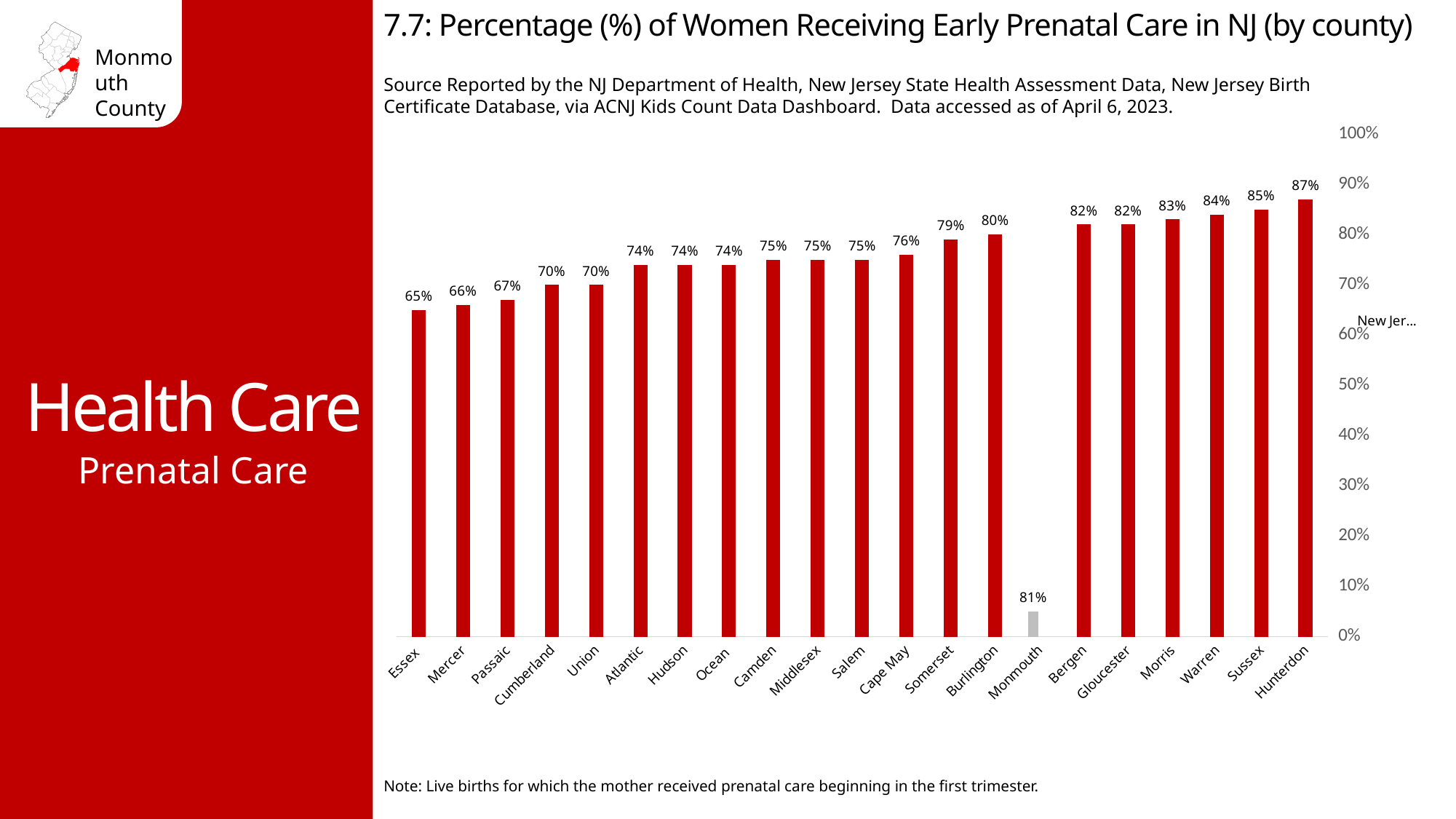
What is the value for Essex County? 65% What is the value for Hunterdon County? 87% Which county's bar is coloured gray instead of red? Monmouth Is the value for Essex greater or less than 70%? less Which is larger, the value for Bergen or the value for Somerset? Bergen What is the difference between the values for Hunterdon and Essex? 22 percentage points How many counties are shown on the x axis? 21 Which county has the lowest percentage of women receiving early prenatal care? Essex Do the values generally rise or fall from left to right along the x axis? rise What is the value for Monmouth County? 81% What kind of chart is shown on the slide? bar chart Which county has the highest percentage of women receiving early prenatal care? Hunterdon